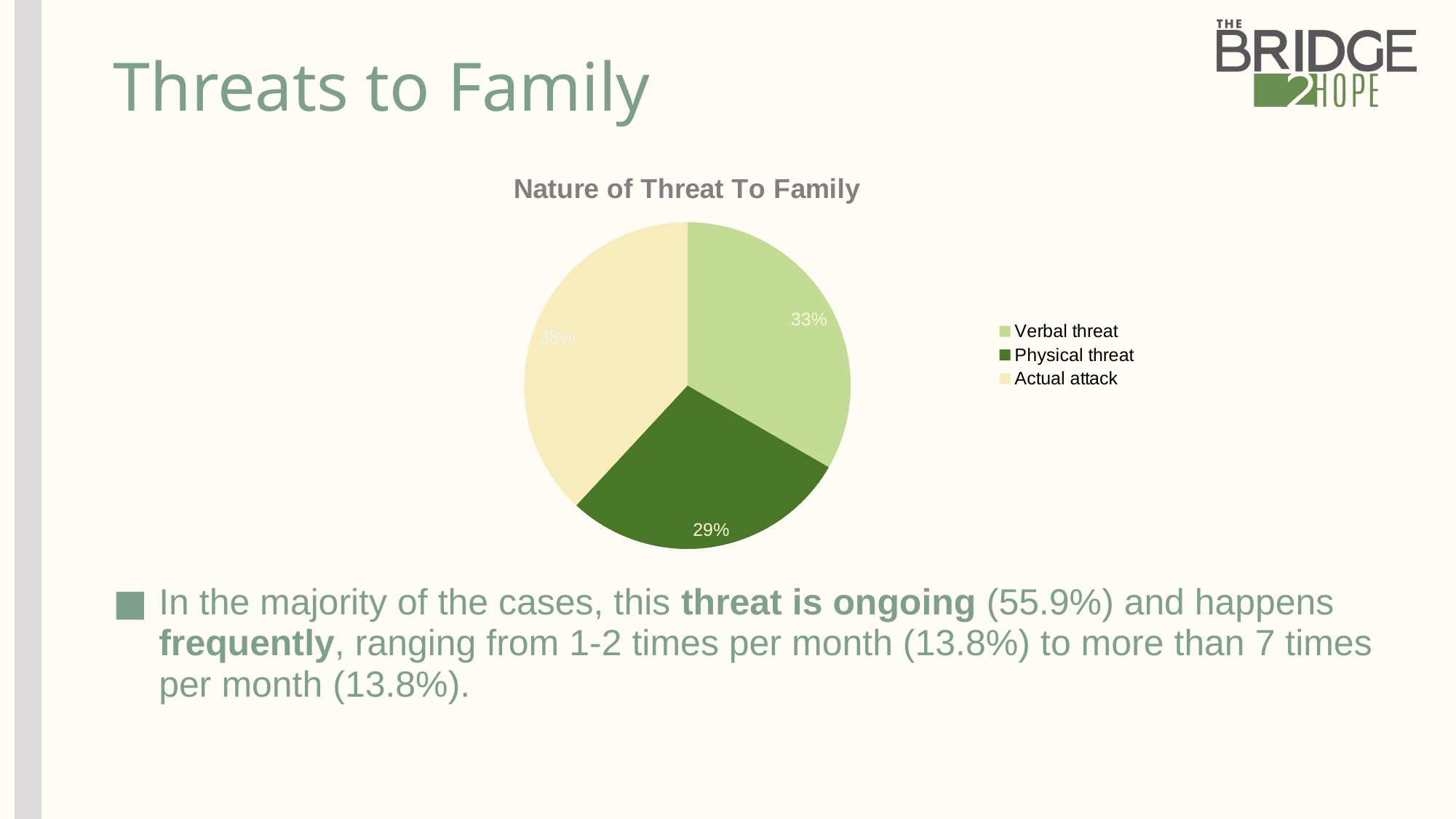
What percentage of the pie is Physical threat? 29% What percentage of the pie is Verbal threat? 33% What type of chart is shown on the slide? Pie chart Which legend entry is shown in the darkest green colour? Physical threat What is the title of the chart? Nature of Threat To Family How many categories does the pie chart show? 3 What is the difference in percentage points between Actual attack and Verbal threat? 5 Which category has the largest share of the pie? Actual attack Which category has the smallest share of the pie? Physical threat What is the difference in percentage points between Actual attack and Physical threat? 9 Which is larger, the share for Verbal threat or the share for Physical threat? Verbal threat What percentage of the pie is Actual attack? 38%